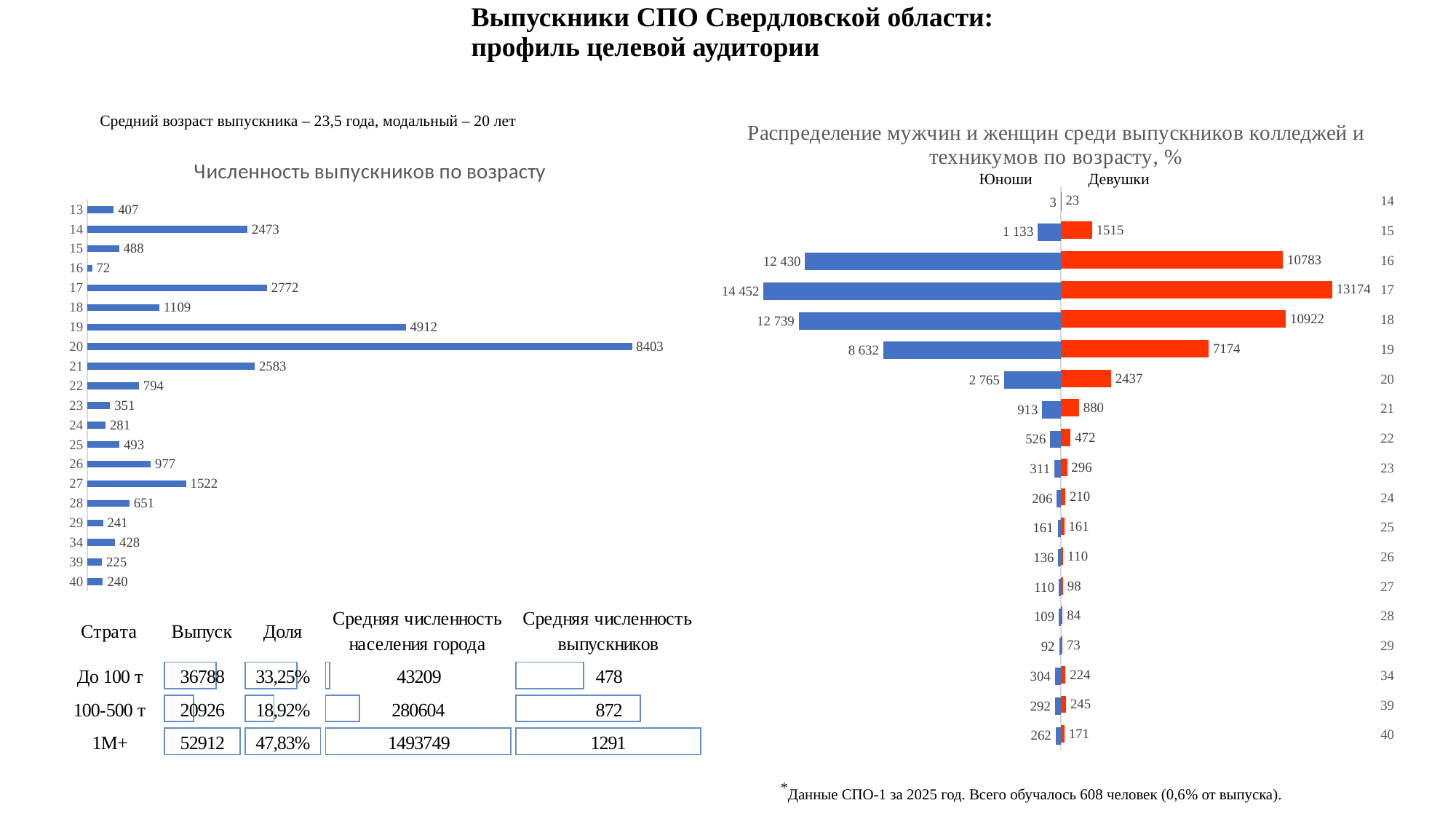
In the chart 'Распределение мужчин и женщин среди выпускников колледжей и техникумов по возрасту, %', what is the value for Девушки at age 16? 10783 In the chart 'Распределение мужчин и женщин среди выпускников колледжей и техникумов по возрасту, %', what is the difference between Юноши and Девушки at age 19? 1458 In the chart 'Численность выпускников по возрасту', which age has the highest value? 20 What type of chart is 'Численность выпускников по возрасту'? Bar chart In the chart 'Численность выпускников по возрасту', which age has the lowest value? 16 In the chart 'Численность выпускников по возрасту', what is the value for age 20? 8403 In the chart 'Распределение мужчин и женщин среди выпускников колледжей и техникумов по возрасту, %', what is the value for Юноши at age 17? 14 452 In the chart 'Численность выпускников по возрасту', what is the difference between the values for age 19 and age 21? 2329 In the chart 'Распределение мужчин и женщин среди выпускников колледжей и техникумов по возрасту, %', how many series are shown? 2 In the chart 'Численность выпускников по возрасту', how many age categories are shown? 20 In the chart 'Распределение мужчин и женщин среди выпускников колледжей и техникумов по возрасту, %', which colour represents Девушки? Red In the chart 'Распределение мужчин и женщин среди выпускников колледжей и техникумов по возрасту, %', which is larger at age 15: Юноши or Девушки? Девушки